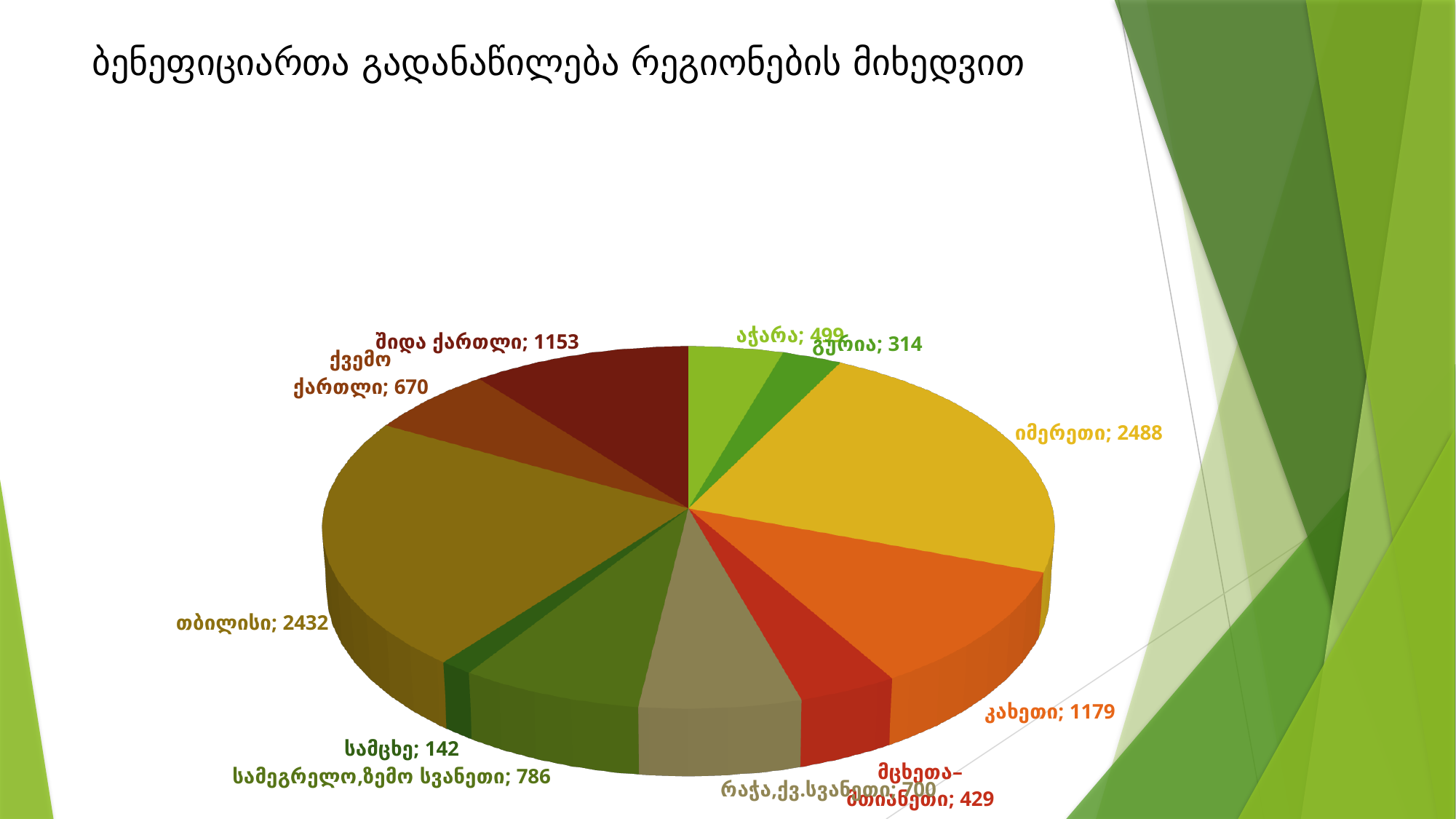
How many regions (slices) are shown in the pie chart? 11 What is the value for იმერეთი? 2488 What is the value for სამეგრელო,ზემო სვანეთი? 786 What is the value for კახეთი? 1179 Which region has the smallest slice of the pie? სამცხე What is the title of the chart on the slide? ბენეფიციართა გადანაწილება რეგიონების მიხედვით Which is larger, the value for კახეთი or the value for შიდა ქართლი? კახეთი What is the value for თბილისი? 2432 Which region has the largest slice of the pie? იმერეთი What kind of chart is shown on the slide? pie chart What is the difference between the values for იმერეთი and თბილისი? 56 What is the value for შიდა ქართლი? 1153